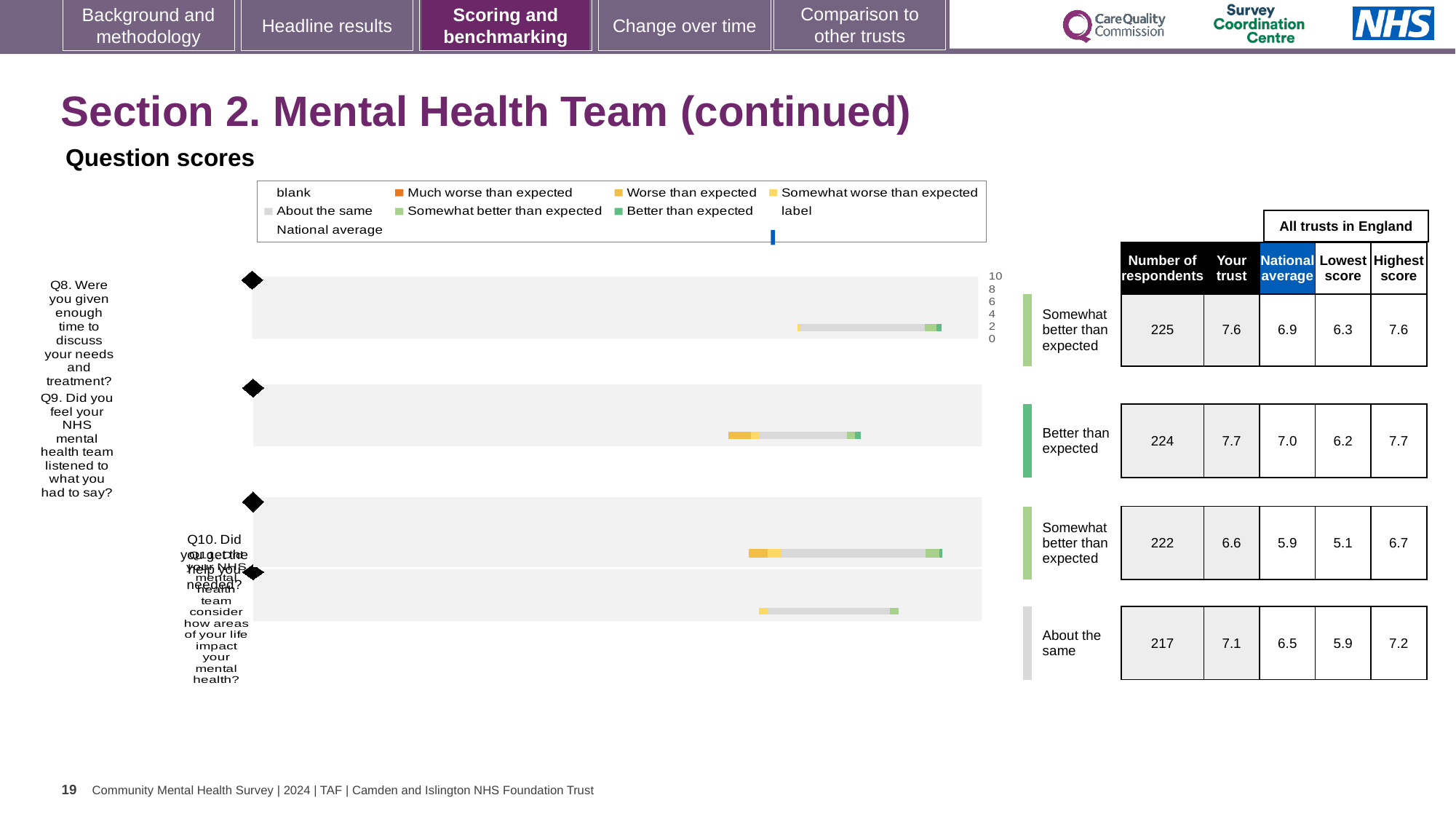
In the table beside the chart, what is the 'Your trust' score for Q8 (Were you given enough time to discuss your needs and treatment?)? 7.6 In the chart legend, what colour represents 'Much worse than expected'? Orange In the table beside the chart, how many respondents are listed for Q9 (Did you feel your NHS mental health team listened to what you had to say?)? 224 For Q8, which is larger in the table: the 'Your trust' score or the 'National average' score? Your trust How many questions (categories) are plotted in the Question scores chart? 4 What kind of chart is shown under 'Question scores'? Bar chart What benchmark category is shown next to the chart for Q9? Better than expected Which question has the highest 'Your trust' score in the table beside the chart? Q9 In the table beside the chart, what is the 'Highest score' for Q10 (Did you get the help you needed?)? 6.7 Which question has the lowest 'Your trust' score in the table beside the chart? Q10 For Q9, what is the difference between the 'Your trust' score and the 'National average' score shown in the table? 0.7